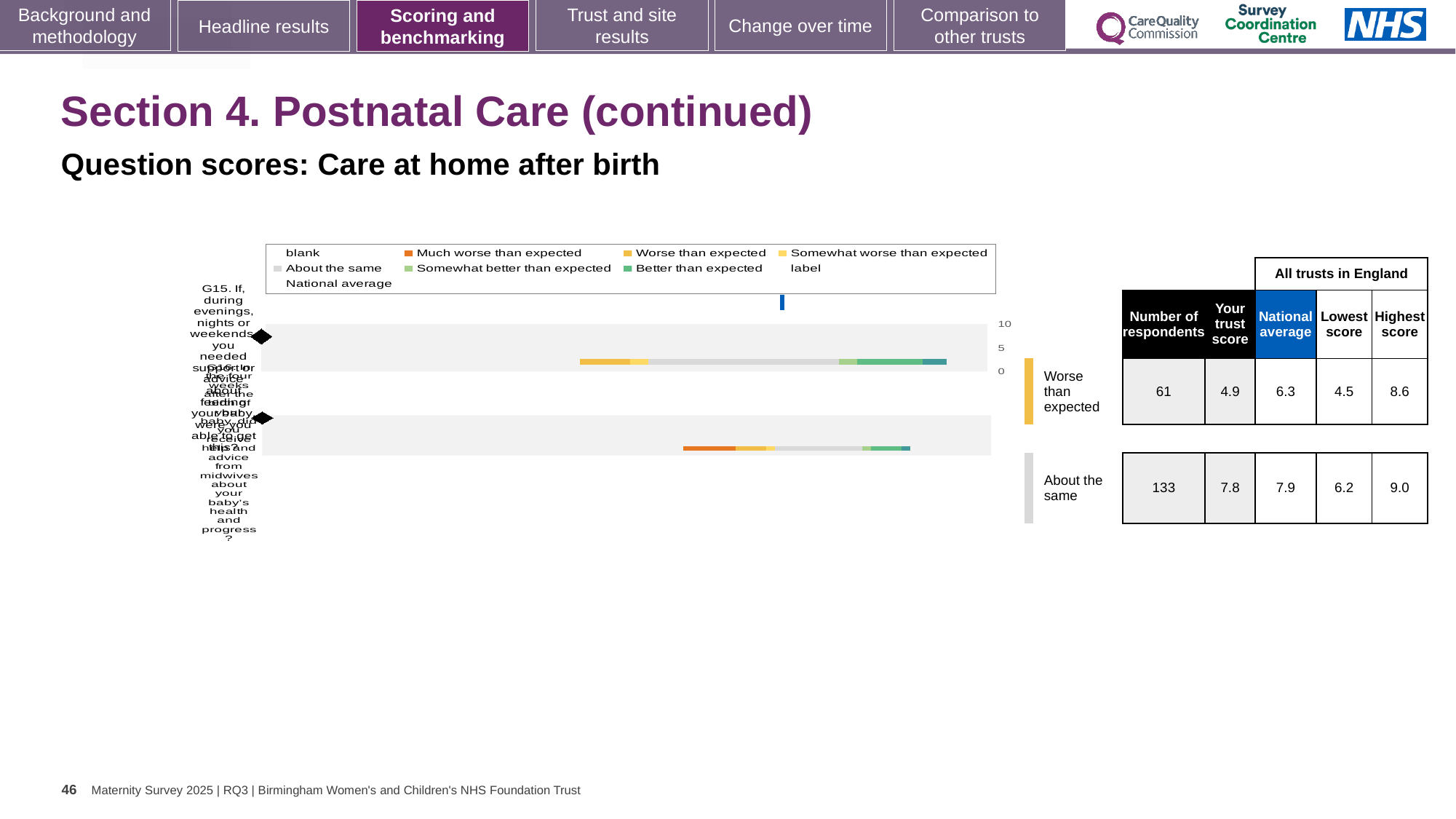
In the table, what is the lowest score for the row marked 'Worse than expected'? 4.5 In the table, what is the highest score for the row marked 'About the same'? 9.0 For the row marked 'About the same', what is the difference between the highest score and the lowest score? 2.8 In the table, what is the national average for the row marked 'About the same'? 7.9 In the table, what is the number of respondents for the row marked 'Worse than expected'? 61 What kind of chart is shown on the slide? bar chart How many questions (bars) are plotted in the chart? 2 For the row marked 'Worse than expected', what is the difference between the national average and the trust score? 1.4 What is the subtitle of the chart section on the slide? Question scores: Care at home after birth In the table, what is 'Your trust score' for the row marked 'Worse than expected'? 4.9 Which row has more respondents: 'Worse than expected' or 'About the same'? About the same For the row marked 'Worse than expected', which is larger: the trust score or the national average? national average